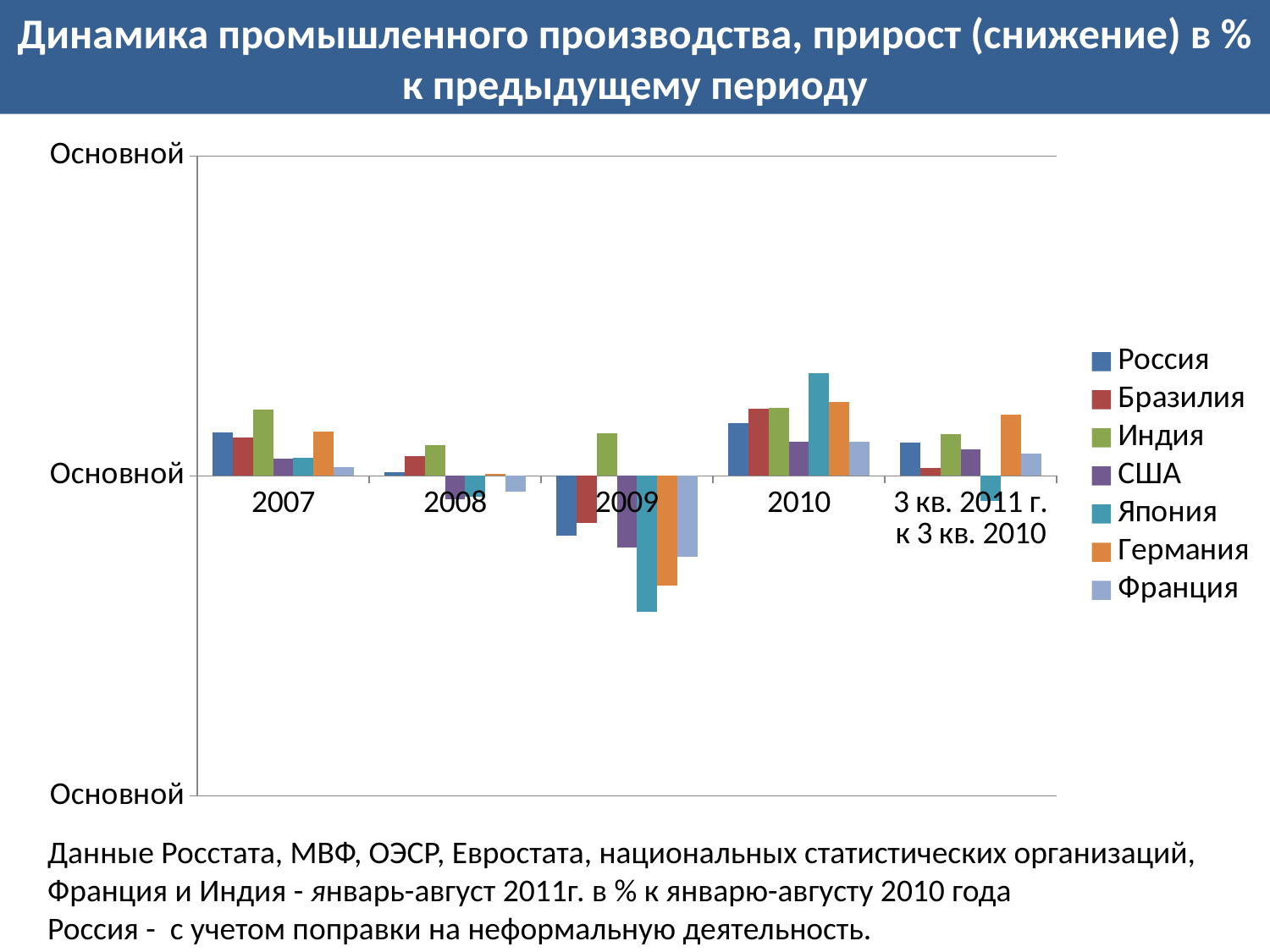
Which series is listed first in the legend? Россия How many period categories are shown along the x axis? 5 Which country has the highest value in 2010? Япония What kind of chart is shown on the slide? bar chart Which country has the highest value for 3 кв. 2011 г. к 3 кв. 2010? Германия Which country has the highest value in 2007? Индия In 2010, which is larger: the value for Россия or the value for Япония? Япония Which country has the lowest value for 3 кв. 2011 г. к 3 кв. 2010? Япония Does the value for Россия rise or fall from 2007 to 2009? fall Which country has the lowest value in 2009? Япония How many series does the legend list? 7